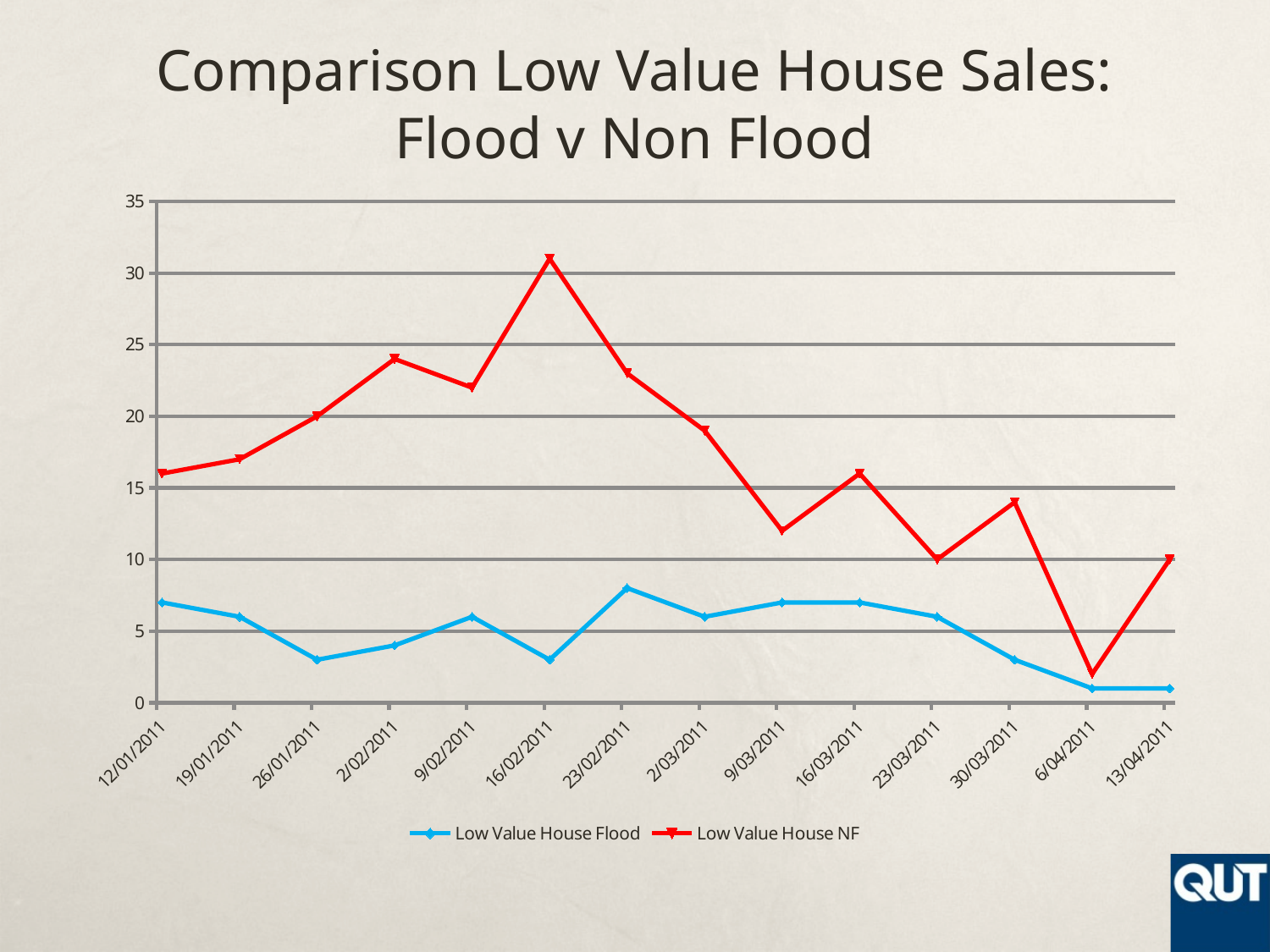
On which date does the Low Value House NF series reach its highest value? 16/02/2011 On 9/03/2011, which series has the larger value, Low Value House Flood or Low Value House NF? Low Value House NF Which colour is used for the Low Value House NF series? red How many series does the legend list? 2 Does the Low Value House Flood series rise or fall between 30/03/2011 and 13/04/2011? fall What is the value of Low Value House NF on 23/03/2011? 10 How many dates are plotted along the x axis? 14 On which date does the Low Value House NF series reach its lowest value? 6/04/2011 Is the value for Low Value House Flood on 23/02/2011 greater or less than 10? less Is the value for Low Value House NF on 16/02/2011 greater or less than 30? greater What kind of chart is shown on the slide? line chart What is the value of Low Value House NF on 26/01/2011? 20